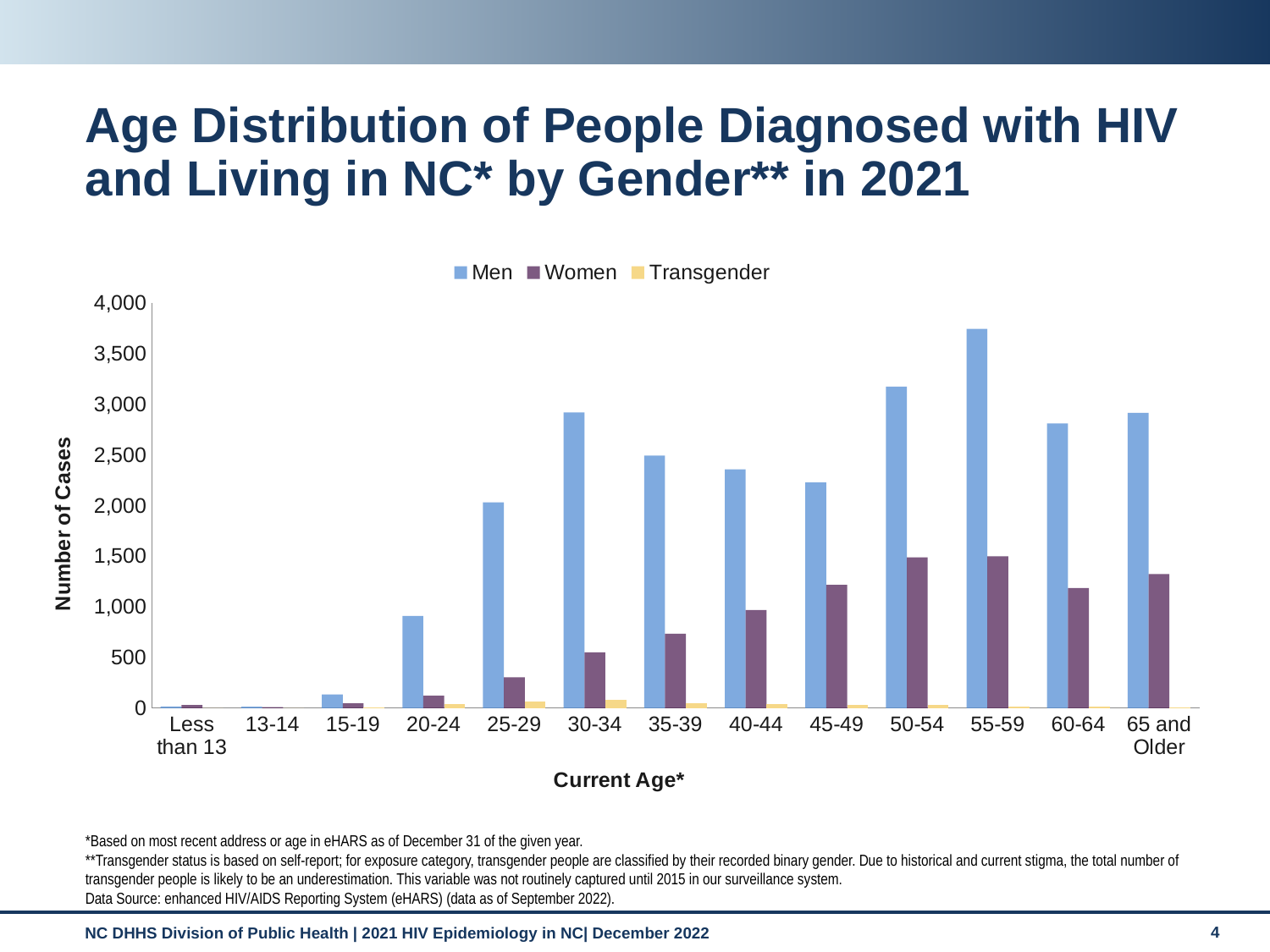
Is the value for Men in the 50-54 age group greater or less than 3,000? greater How many age categories are shown on the x axis? 13 What type of chart is shown on the slide? bar chart What is the label of the y axis? Number of Cases How many series does the legend list? 3 Is the value for Men in the 20-24 age group greater or less than 1,000? less Does the number of cases among Men rise or fall from the 55-59 age group to the 60-64 age group? fall Which is larger: the number of cases among Men aged 50-54 or Men aged 60-64? Men aged 50-54 Is the value for Women in the 25-29 age group greater or less than 500? less For which age group is the number of cases among Men highest? 55-59